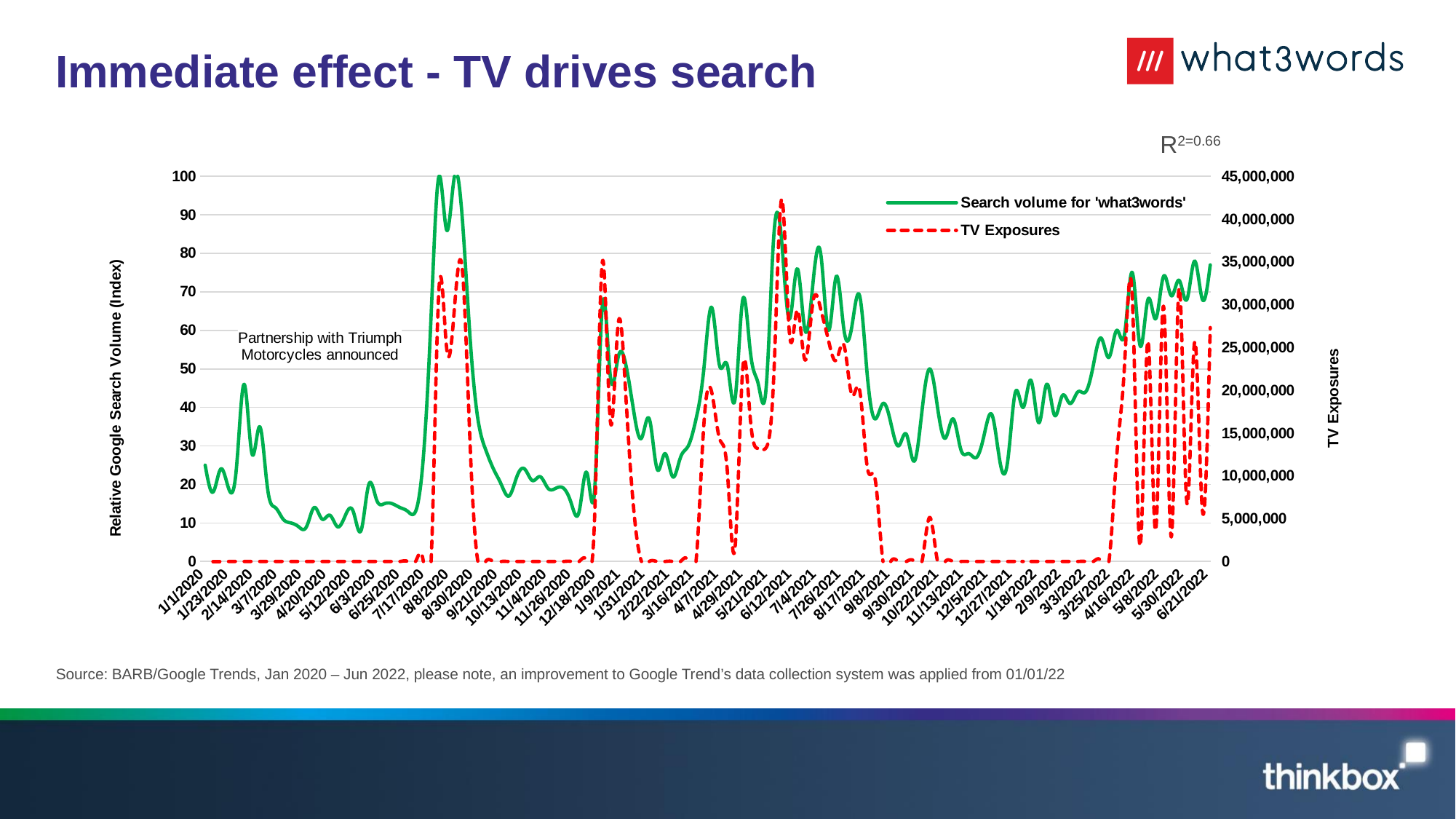
Which is larger: the 'Search volume for what3words' value at 8/8/2020 or at 1/1/2020? 8/8/2020 Does the 'Search volume for what3words' series rise or fall between 12/27/2021 and 6/21/2022? rise What kind of chart is shown on the slide? Line chart What is the title of the left vertical axis? Relative Google Search Volume (Index) How many series does the chart's legend list? 2 Is the 'TV Exposures' value at 1/1/2020 greater or less than 5,000,000? less Is the peak 'TV Exposures' value around 6/12/2021 greater or less than 40,000,000? greater Around which month does the 'Search volume for what3words' series reach its peak of 100? August 2020 Which series is drawn as a red dashed line? TV Exposures What is the highest value reached by the 'Search volume for what3words' series? 100